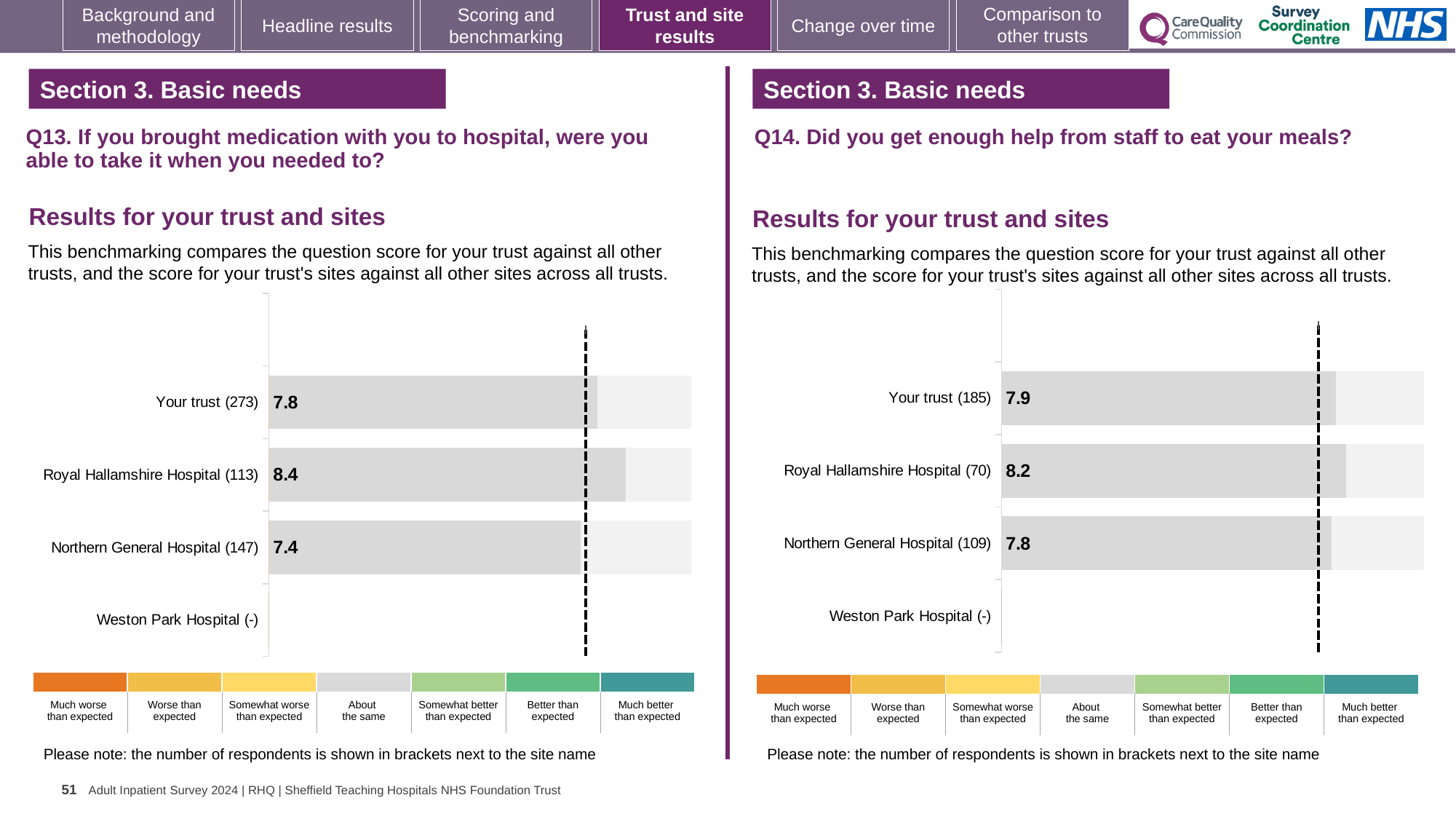
In the Q14 chart on the right, what is the difference between the scores for Royal Hallamshire Hospital and Your trust? 0.3 In the Q13 chart on the left, what is the difference between the scores for Royal Hallamshire Hospital and Northern General Hospital? 1.0 In the Q13 chart on the left, which site has the highest score? Royal Hallamshire Hospital In the Q14 chart on the right, how many respondents are shown for Northern General Hospital? 109 In the Q14 chart on the right, which site with a score shown has the lowest score? Northern General Hospital In the Q13 chart on the left, what is the score for Royal Hallamshire Hospital? 8.4 What type of chart is used in the Q13 chart on the left? Bar chart In the Q14 chart on the right, is the score for Royal Hallamshire Hospital or Northern General Hospital larger? Royal Hallamshire Hospital In the Q13 chart on the left, what is the score for Northern General Hospital? 7.4 In the Q14 chart on the right, what is the score for Your trust? 7.9 In the Q13 chart on the left, how many respondents are shown for Your trust? 273 In the Q14 chart on the right, what is the score for Royal Hallamshire Hospital? 8.2